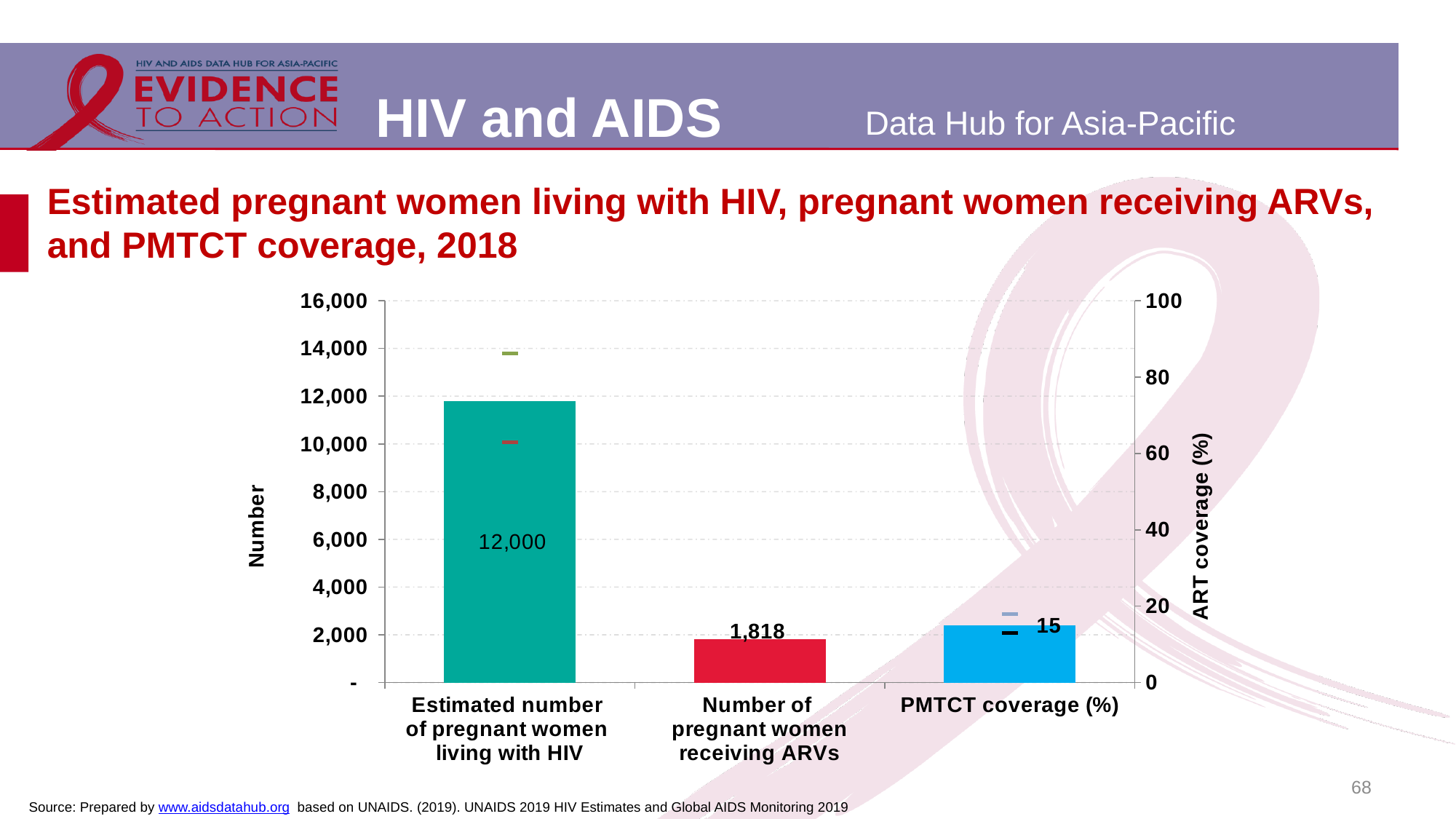
What is the difference between the estimated number of pregnant women living with HIV and the number of pregnant women receiving ARVs? 10,182 How many categories are shown on the x axis of the chart? 3 Which is larger: the estimated number of pregnant women living with HIV or the number of pregnant women receiving ARVs? Estimated number of pregnant women living with HIV Is the number of pregnant women receiving ARVs greater or less than 2,000? less What is the label of the left vertical axis of the chart? Number What is the estimated number of pregnant women living with HIV shown on the chart? 12,000 What is the PMTCT coverage (%) value shown on the chart? 15 Is the PMTCT coverage (%) greater or less than 20 on the right-hand axis? less What is the label of the right vertical axis of the chart? ART coverage (%) What type of chart is shown on the slide? Bar chart Which category has the tallest bar on the chart? Estimated number of pregnant women living with HIV What is the number of pregnant women receiving ARVs shown on the chart? 1,818